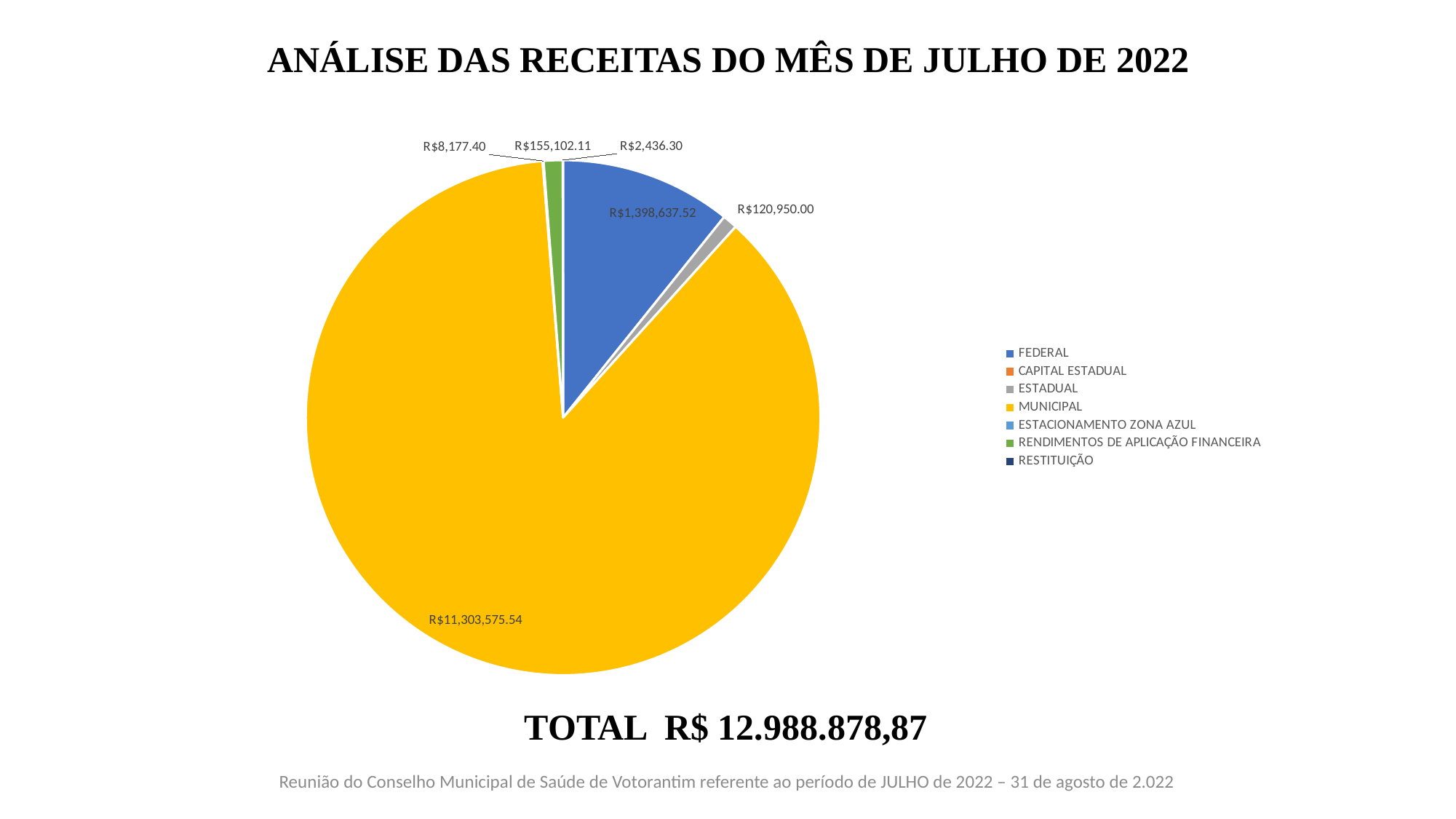
Which category has the largest slice of the pie? MUNICIPAL What is the value of the ESTADUAL slice? R$120,950.00 How many categories does the legend list? 7 What is the value of the FEDERAL slice? R$1,398,637.52 What is the smallest value labelled on the pie chart? R$2,436.30 What is the title of the chart? ANÁLISE DAS RECEITAS DO MÊS DE JULHO DE 2022 What kind of chart is shown on the slide? pie chart What is the value of the RENDIMENTOS DE APLICAÇÃO FINANCEIRA slice? R$155,102.11 What is the value of the MUNICIPAL slice? R$11,303,575.54 Which is larger, the FEDERAL slice or the ESTADUAL slice? FEDERAL What total is printed below the pie chart? R$ 12.988.878,87 What is the difference between the FEDERAL value and the ESTADUAL value? R$1,277,687.52